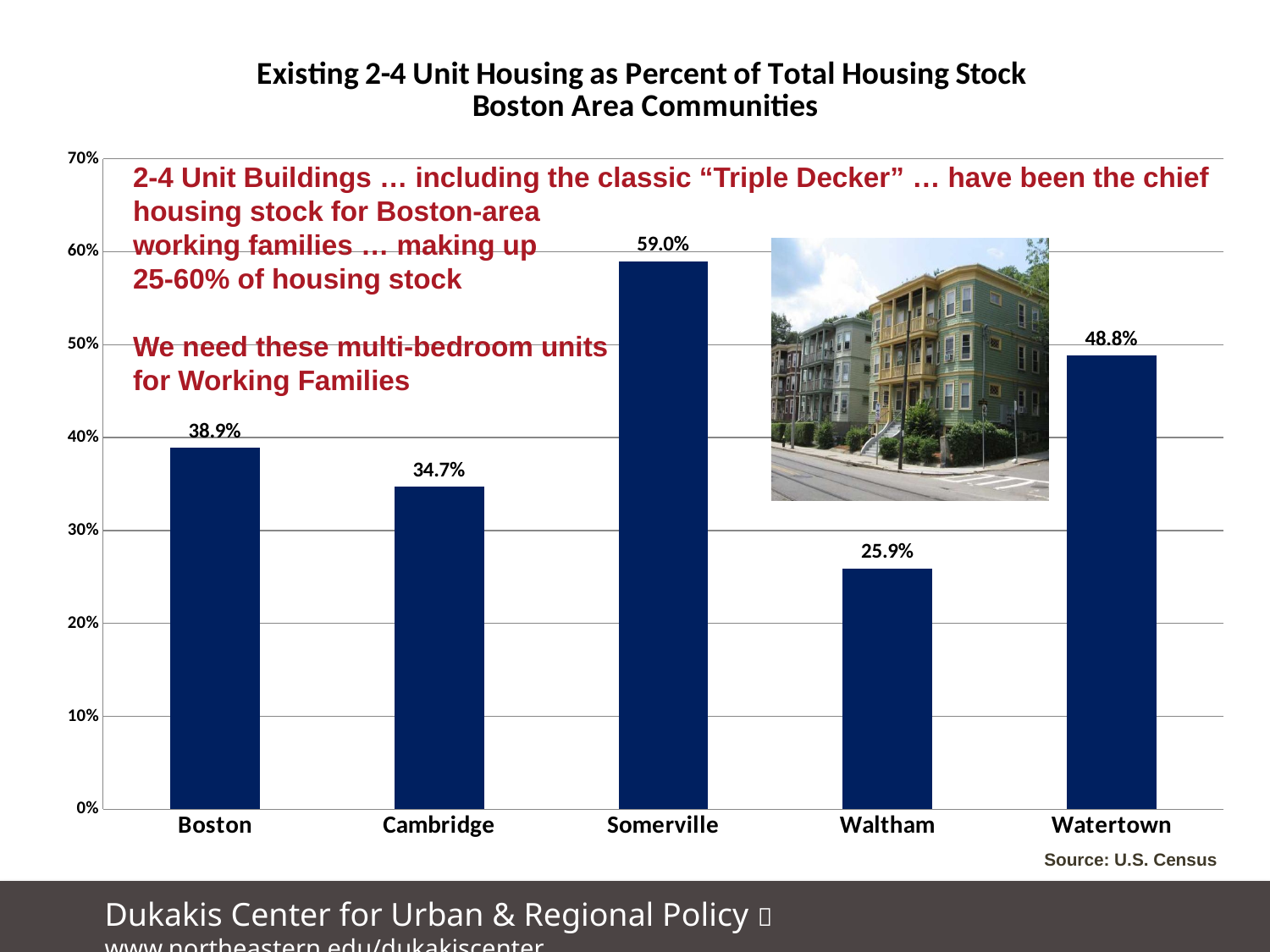
What is the value for Waltham? 25.9% How many communities are shown on the chart? 5 What kind of chart is shown on the slide? bar chart Is the value for Watertown greater or less than 40%? greater Which community has the lowest percentage of 2-4 unit housing? Waltham What is the source cited for the chart data? U.S. Census What is the difference between the values for Somerville and Waltham? 33.1% Which is larger, the value for Watertown or the value for Cambridge? Watertown What is the value for Somerville? 59.0% What is the value for Boston? 38.9% What is the difference between the values for Boston and Cambridge? 4.2% Which community has the highest percentage of 2-4 unit housing? Somerville